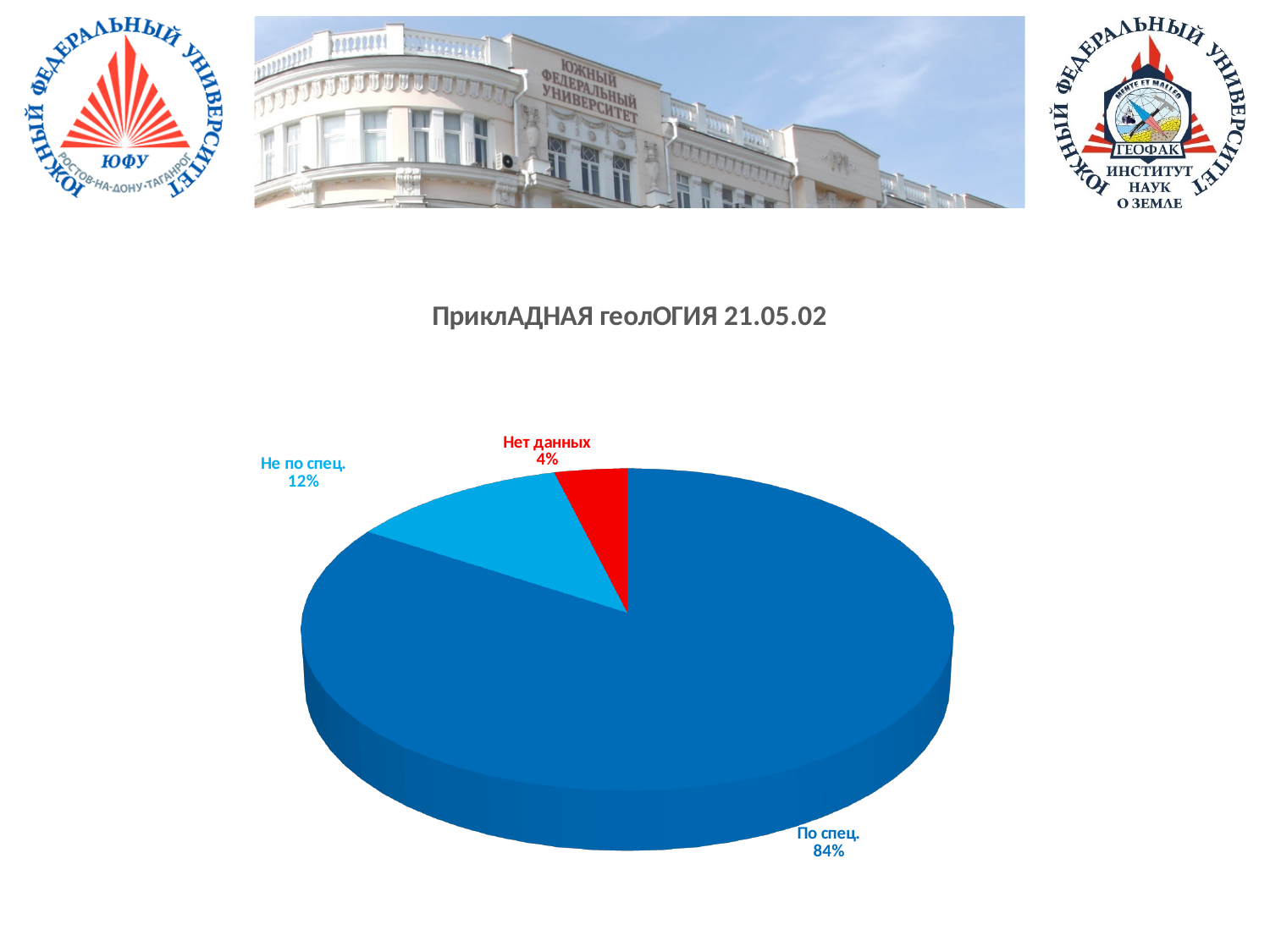
Which category has the smallest slice of the pie? Нет данных What share of the pie does "Не по спец." hold? 12% Which is larger, the share for "Не по спец." or the share for "Нет данных"? Не по спец. Which category has the largest slice of the pie? По спец. What share of the pie does "Нет данных" hold? 4% What share of the pie does "По спец." hold? 84% How many slices does the pie chart have? 3 What is the title of the chart? ПриклАДНАЯ геолОГИЯ 21.05.02 What is the difference in percentage points between "По спец." and "Не по спец."? 72 What is the difference in percentage points between "Не по спец." and "Нет данных"? 8 What kind of chart is shown on the slide? Pie chart What colour is the "Нет данных" slice? Red